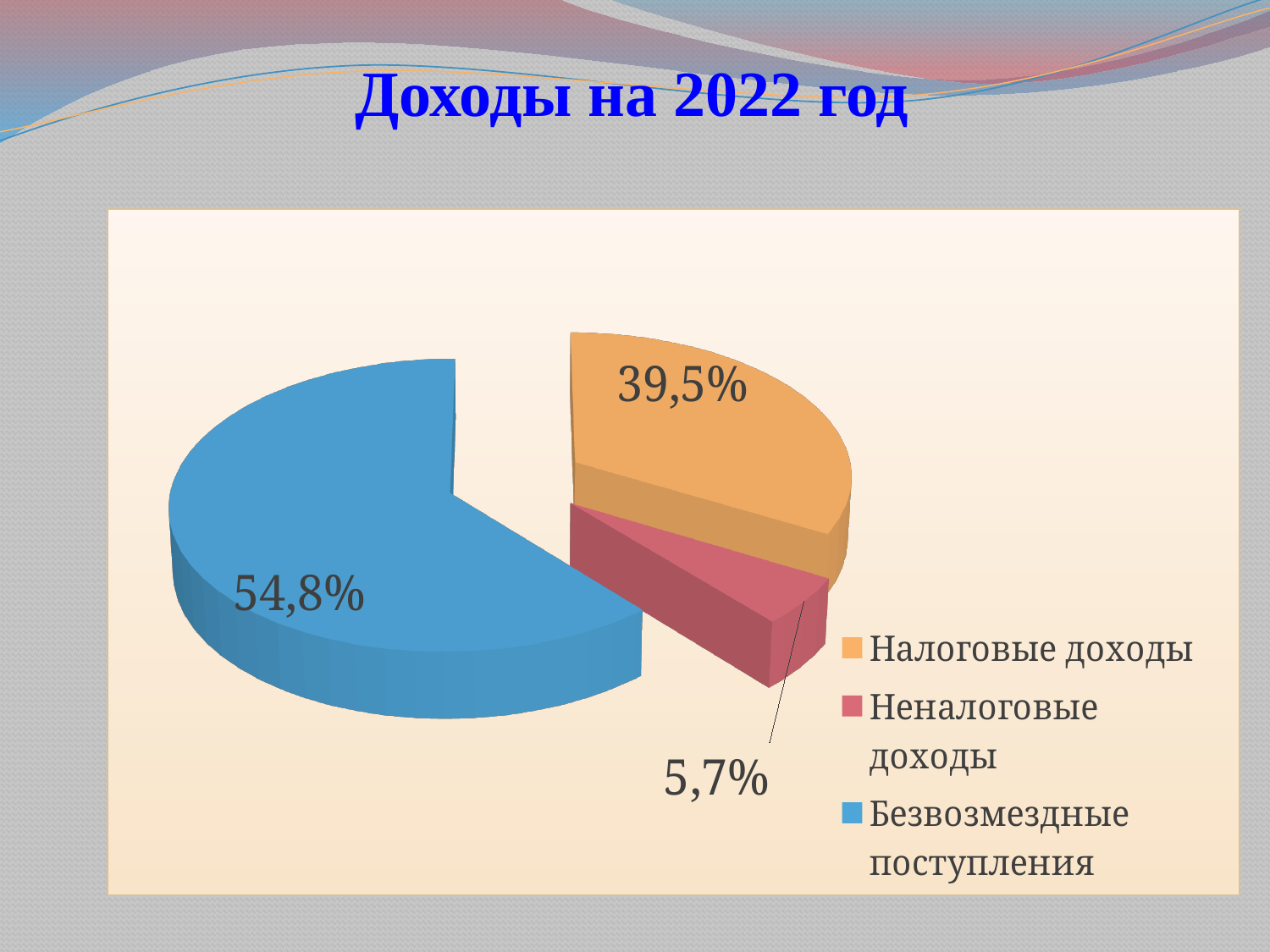
What is the share for Неналоговые доходы? 5,7% What kind of chart is shown on the slide? pie chart What is the difference between the shares of Безвозмездные поступления and Налоговые доходы? 15,3% How many entries does the legend list? 3 What is the share for Налоговые доходы? 39,5% Which category has the largest share of the pie? Безвозмездные поступления Which is larger, the share of Налоговые доходы or the share of Неналоговые доходы? Налоговые доходы Which category has the smallest share of the pie? Неналоговые доходы How many slices does the pie chart have? 3 What is the difference between the shares of Налоговые доходы and Неналоговые доходы? 33,8% What is the title of the slide? Доходы на 2022 год What is the share for Безвозмездные поступления? 54,8%